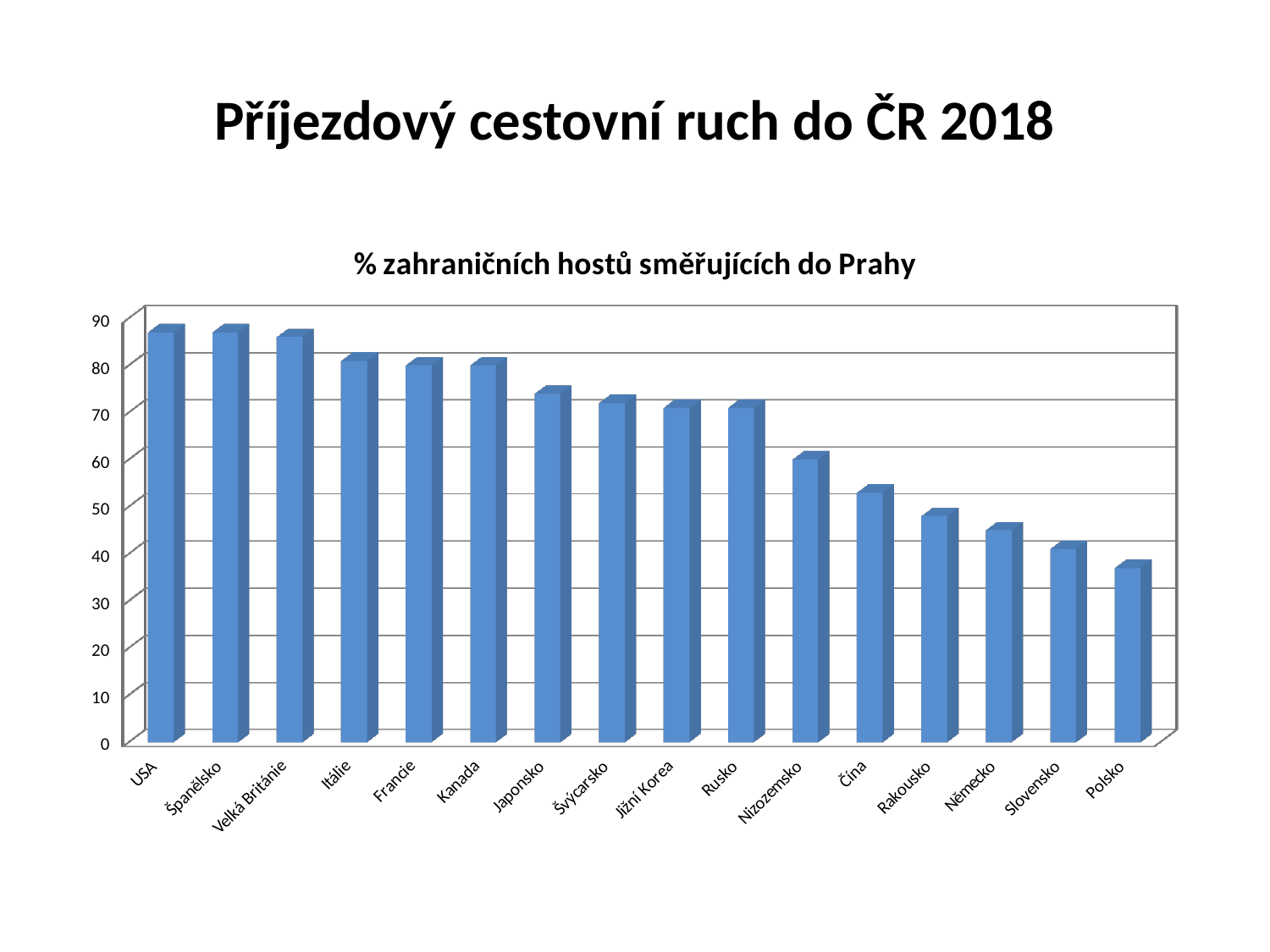
Is the value for Čína greater or less than 50? greater Do the values rise or fall moving from left to right along the x axis? fall Is the value for Japonsko greater or less than 70? greater Is the value for Polsko greater or less than 40? less Which has the larger value, Itálie or Nizozemsko? Itálie What is the title of the chart? % zahraničních hostů směřujících do Prahy How many countries are shown on the x axis of the chart? 16 What kind of chart is shown on the slide? bar chart Which has the larger value, Rakousko or Velká Británie? Velká Británie Which country has the lowest value in the chart? Polsko